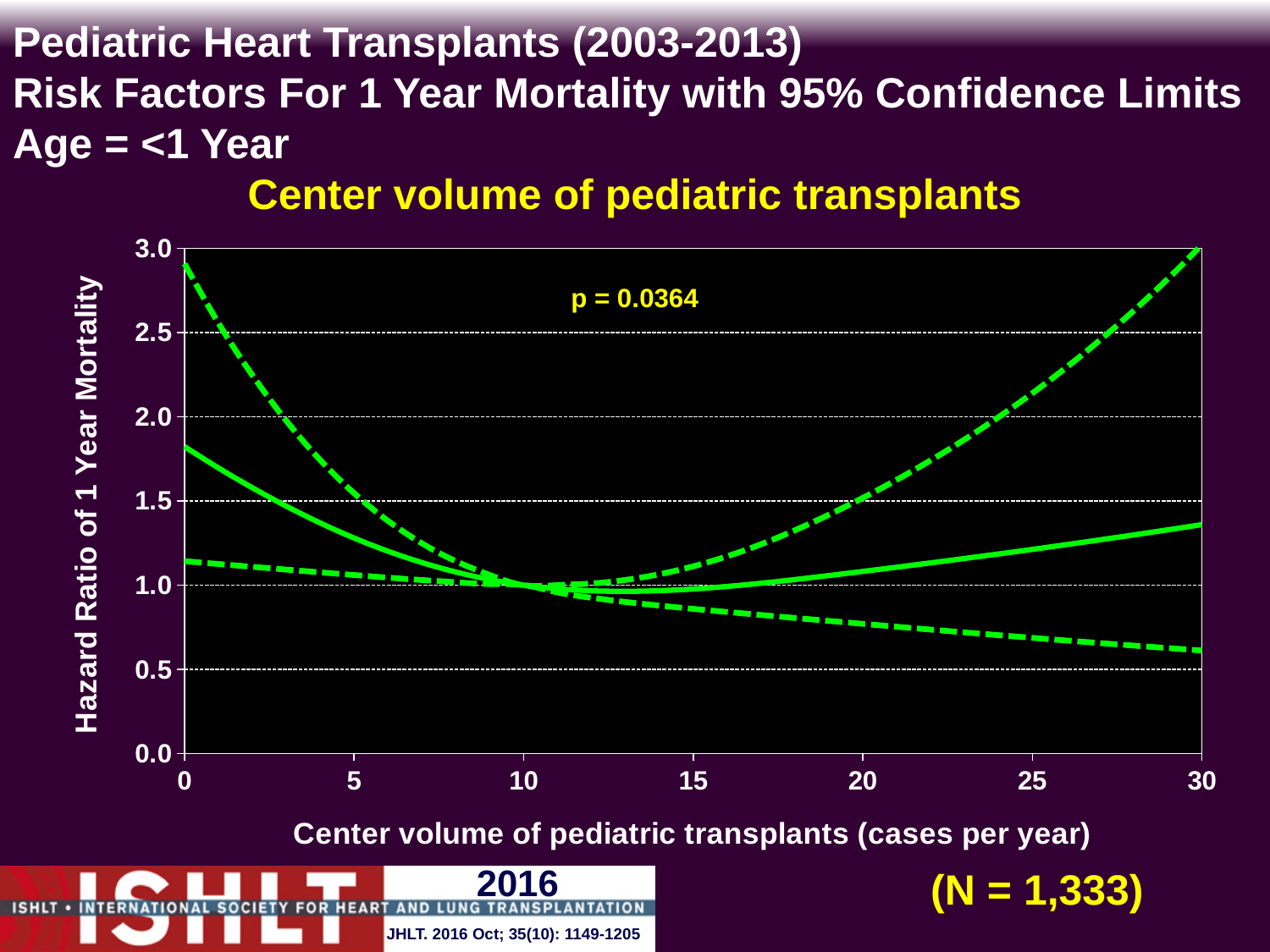
Is the value of the solid line at a center volume of 30 cases per year greater or less than 1.0? greater Is the value of the lower dashed line at a center volume of 30 cases per year greater or less than 1.0? less Does the solid line rise or fall as center volume increases from 0 to 10 cases per year? fall What is the title of the chart? Center volume of pediatric transplants How many lines are plotted on the chart? 3 Does the solid line rise or fall as center volume increases from 15 to 30 cases per year? rise What is the label of the y axis? Hazard Ratio of 1 Year Mortality Is the value of the upper dashed line at a center volume of 0 cases per year greater or less than 2.5? greater What p-value is printed on the chart? p = 0.0364 What kind of chart is shown on the slide? line chart